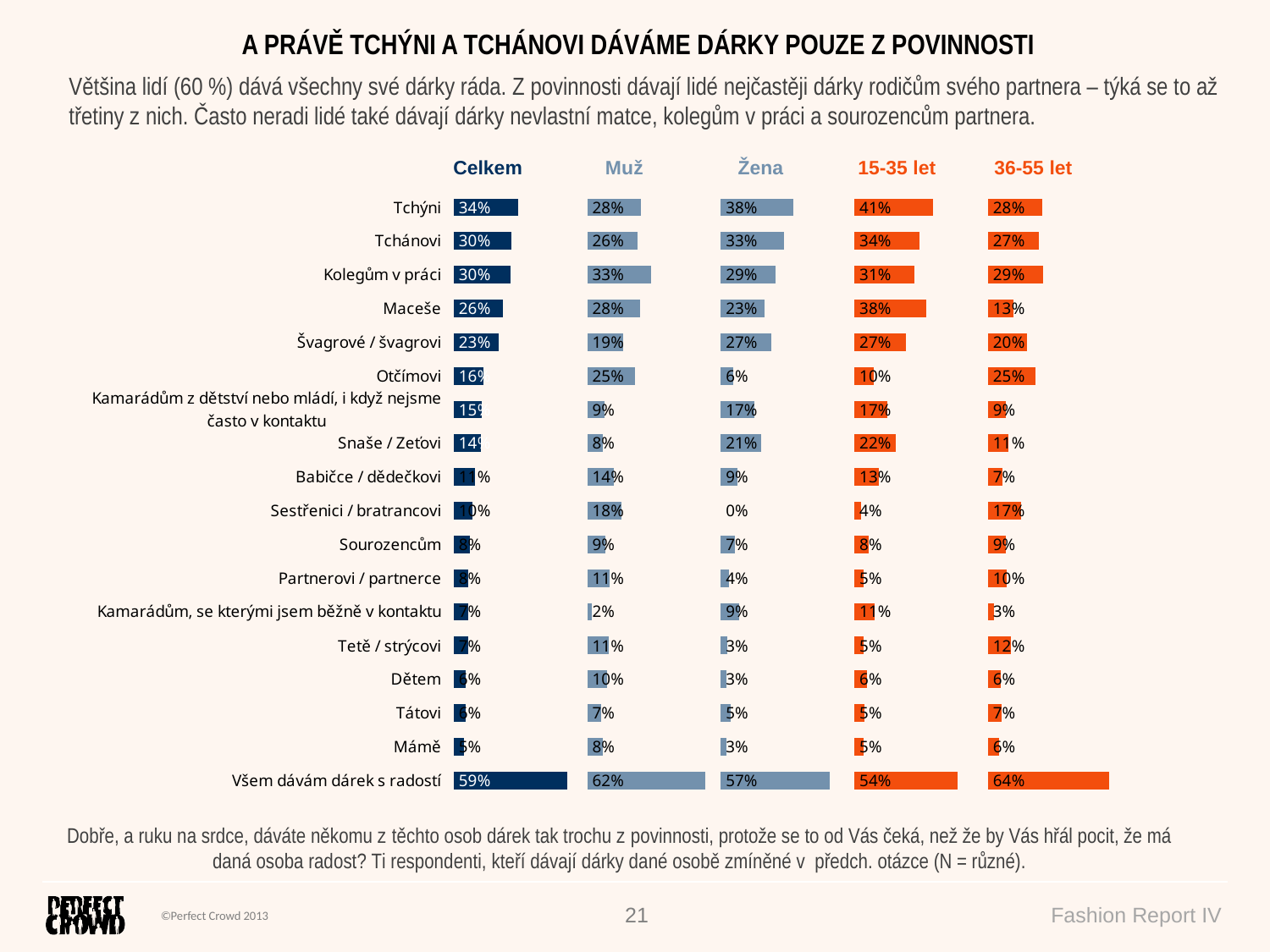
What is the difference between the Žena and Muž values for Tchýni? 10% What type of chart is used for the Celkem data? Bar chart Which is larger for Otčímovi: the Muž value or the Žena value? Muž In the 36-55 let chart, what is the value for Všem dávám dárek s radostí? 64% In the Žena chart, what is the value for Sestřenici / bratrancovi? 0% In the 15-35 let chart, what is the value for Maceše? 38% What is the difference between the 15-35 let and 36-55 let values for Maceše? 25% In the Muž chart, which category has the lowest value? Kamarádům, se kterými jsem běžně v kontaktu How many categories are shown in the Celkem chart? 18 In the Žena chart, what is the value for Snaše / Zeťovi? 21% In the Celkem chart, what is the value for Tchýni? 34% In the 15-35 let chart, which category has the highest value? Všem dávám dárek s radostí